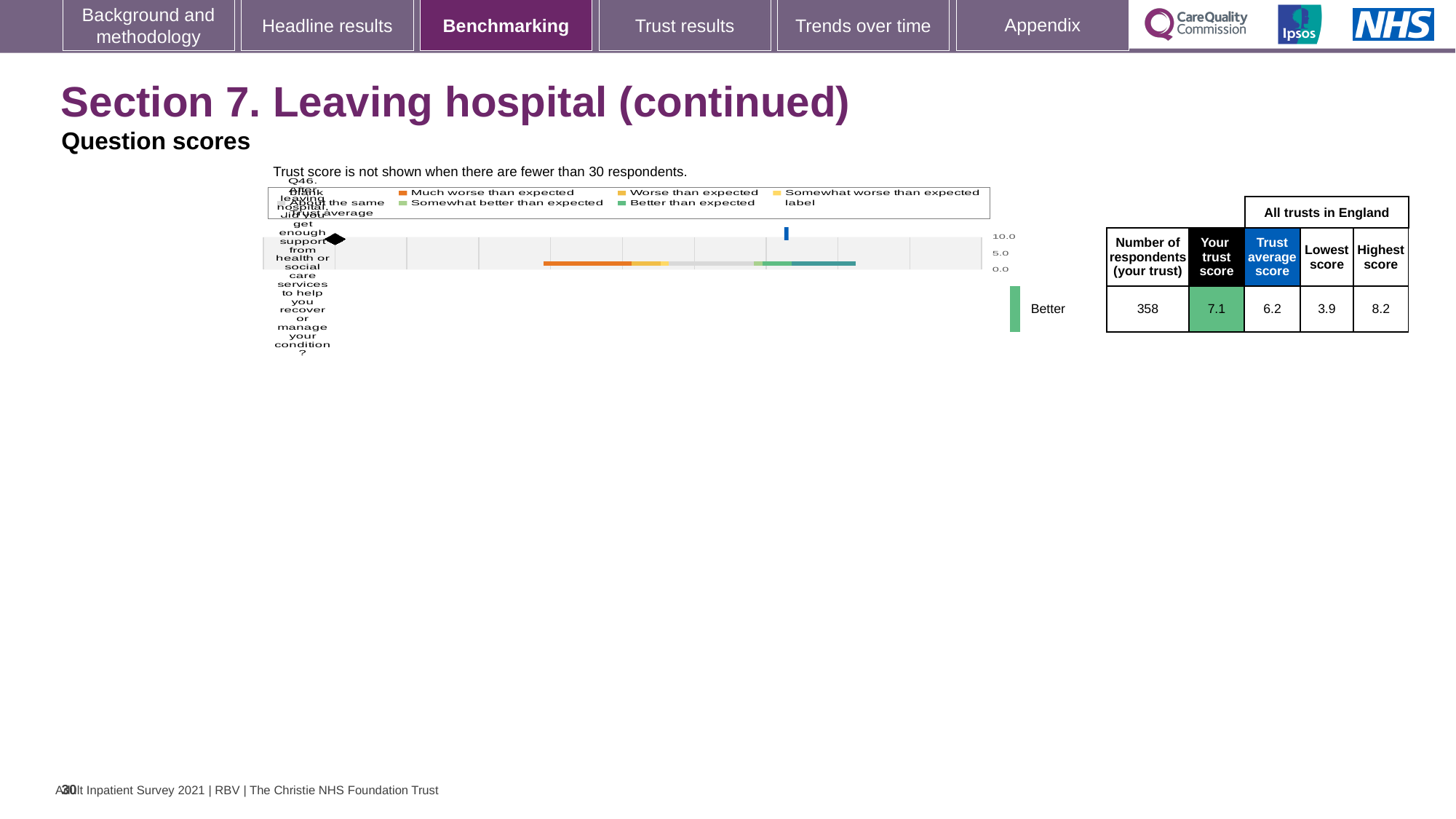
How many questions are plotted on the chart? 1 What is the highest score for Q46 among all trusts in England? 8.2 By how much does the trust's score for Q46 exceed the trust average score? 0.9 What kind of chart is used to show the Q46 benchmarking result? bar chart What is the trust's score for Q46 shown in the table next to the chart? 7.1 What is the difference between the highest and lowest scores for Q46 across all trusts in England? 4.3 Is the trust's score for Q46 greater or less than 5.0 on the chart axis? greater What benchmark category label is shown beside the chart for the trust's Q46 result? Better What is the trust average score for Q46 across all trusts in England? 6.2 How many respondents from the trust answered Q46? 358 What is the lowest score for Q46 among all trusts in England? 3.9 Which is larger for Q46: the trust's own score or the trust average score? The trust's own score